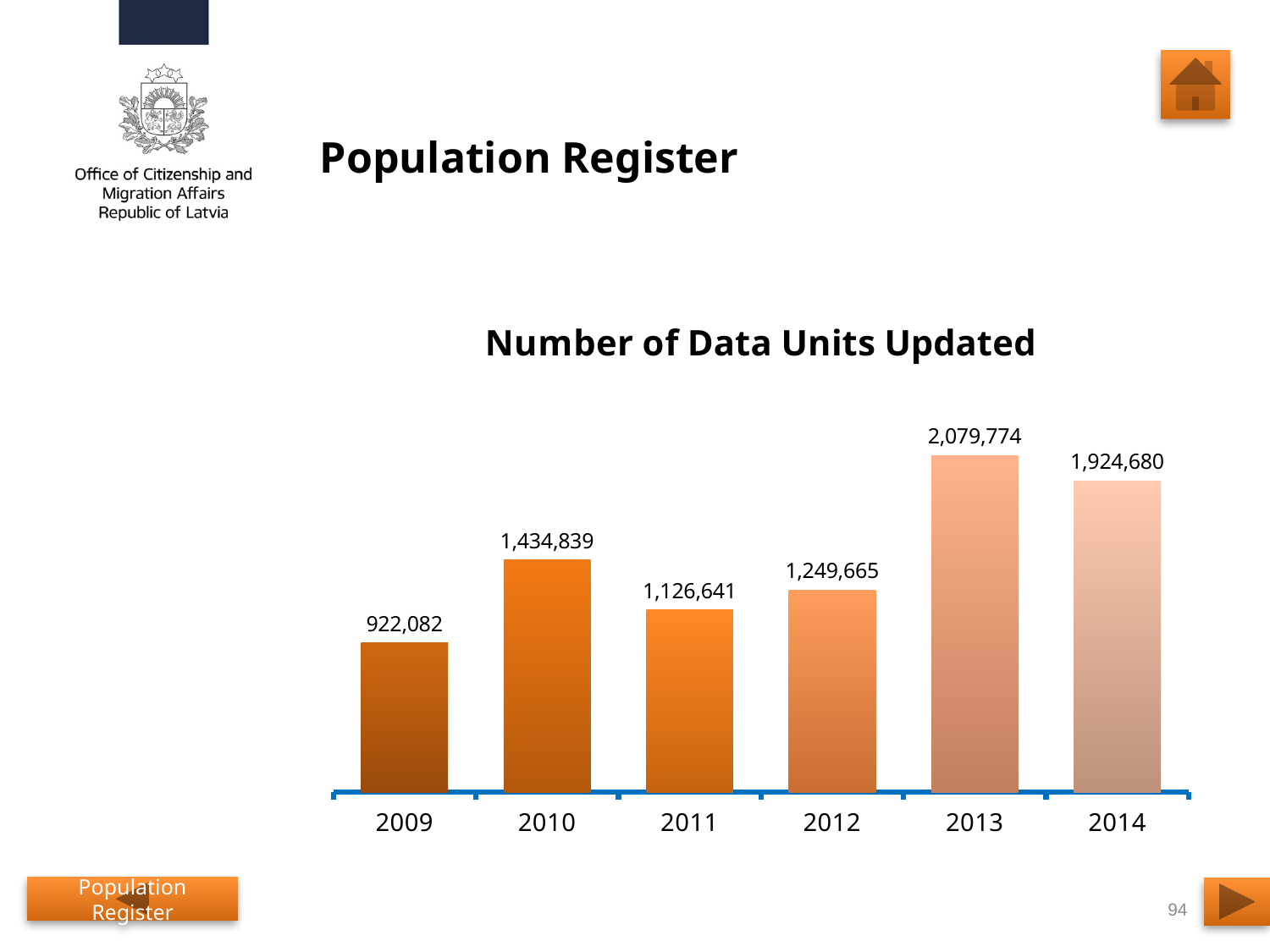
Which year had more data units updated, 2010 or 2012? 2010 What kind of chart is used to show the number of data units updated? Bar chart Did the number of data units updated rise or fall from 2011 to 2013? Rise What is the difference between the number of data units updated in 2010 and in 2009? 512,757 How many years are shown on the chart? 6 What is the number of data units updated in 2014? 1,924,680 What is the number of data units updated in 2011? 1,126,641 What is the number of data units updated in 2009? 922,082 What is the difference between the number of data units updated in 2013 and in 2014? 155,094 What is the number of data units updated in 2013? 2,079,774 Which year has the lowest number of data units updated? 2009 Which year has the highest number of data units updated? 2013